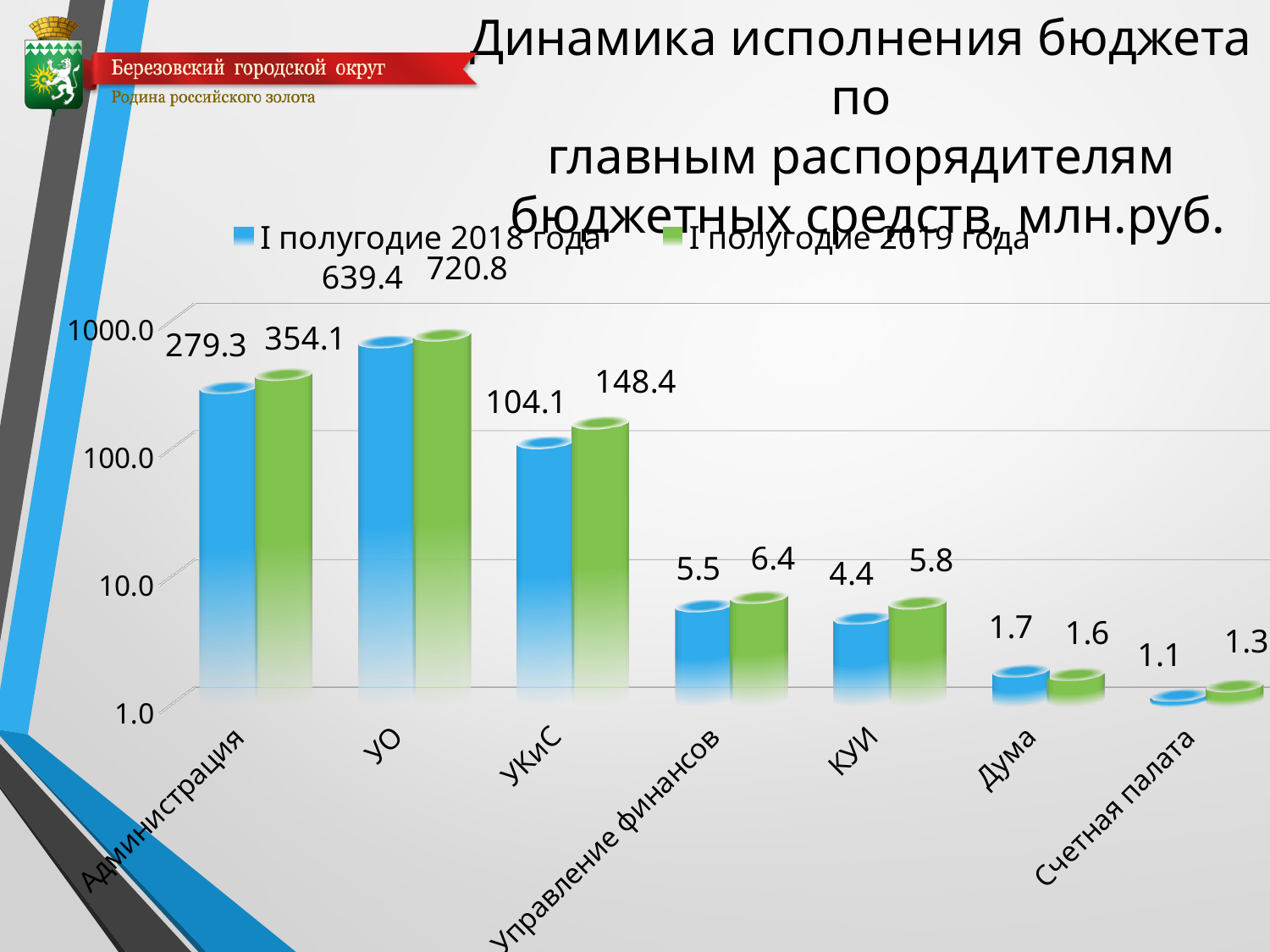
What is the value for КУИ in the series I полугодие 2019 года? 5.8 What is the value for УО in the series I полугодие 2019 года? 720.8 How many series does the legend list? 2 Which category has the lowest value in the series I полугодие 2019 года? Счетная палата How many categories are shown on the x axis? 7 Which category has the highest value in the series I полугодие 2018 года? УО For Дума, which series has the larger value: I полугодие 2018 года or I полугодие 2019 года? I полугодие 2018 года What is the value for Администрация in the series I полугодие 2018 года? 279.3 What is the difference between the I полугодие 2019 года and I полугодие 2018 года values for УКиС? 44.3 Which colour represents the series I полугодие 2019 года? green Is the value for Управление финансов in I полугодие 2018 года greater or less than 10.0? less What kind of chart is shown on the slide? bar chart